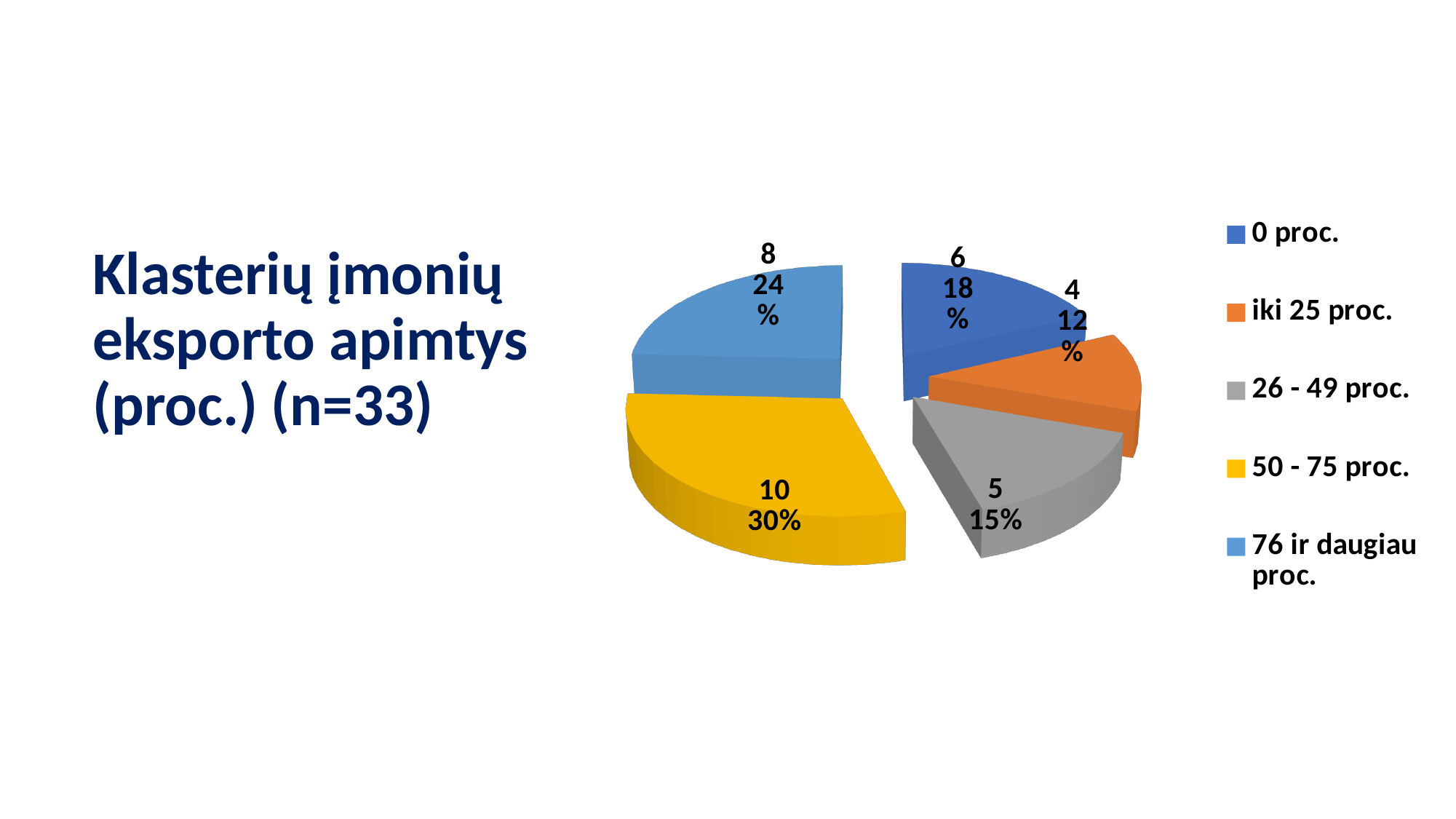
What is the difference in count between the '50 - 75 proc.' slice and the '26 - 49 proc.' slice? 5 What is the count shown for the '50 - 75 proc.' slice? 10 What is the title of the chart on the slide? Klasterių įmonių eksporto apimtys (proc.) (n=33) How many entries does the legend list? 5 What is the count shown for the 'iki 25 proc.' slice? 4 What kind of chart is shown on the slide? Pie chart What percentage share is shown for the '76 ir daugiau proc.' slice? 24% What percentage share is shown for the '0 proc.' slice? 18% Which slice is larger, '0 proc.' or '26 - 49 proc.'? 0 proc. Which category has the smallest slice of the pie? iki 25 proc. Which category has the largest slice of the pie? 50 - 75 proc. How many slices does the pie chart have? 5